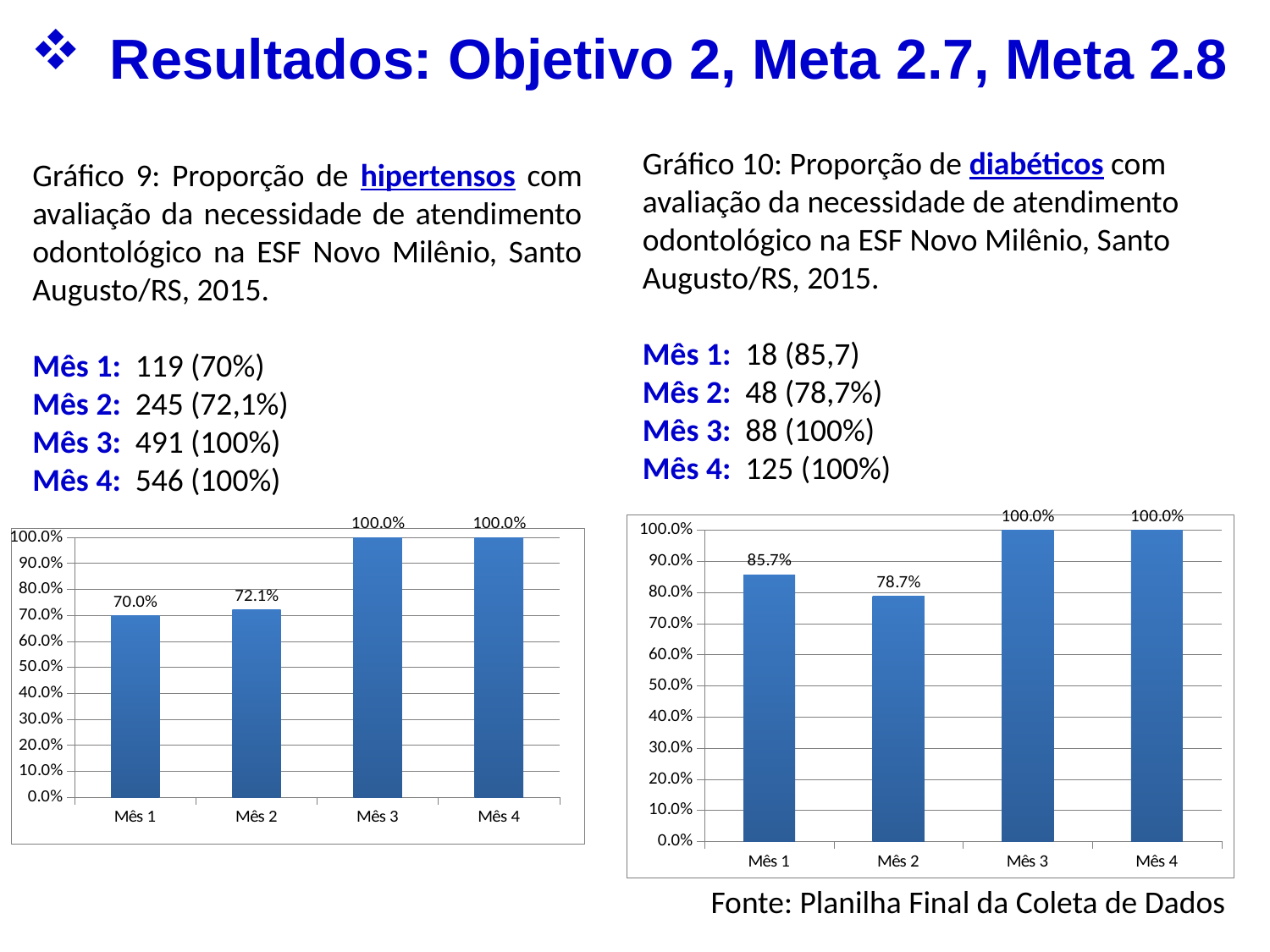
In the left chart (Gráfico 9, hipertensos), what is the difference between the values for Mês 3 and Mês 1? 30.0% What kind of chart is the right chart (Gráfico 10, diabéticos)? Bar chart How many months (categories) are shown in the left chart (Gráfico 9, hipertensos)? 4 In the right chart (Gráfico 10, diabéticos), what is the value for Mês 2? 78.7% In the right chart (Gráfico 10, diabéticos), what is the difference between the values for Mês 1 and Mês 2? 7.0% In the right chart (Gráfico 10, diabéticos), what is the value for Mês 1? 85.7% In the right chart (Gráfico 10, diabéticos), which month has the lowest value? Mês 2 In the left chart (Gráfico 9, hipertensos), which month has the lowest value? Mês 1 In the right chart (Gráfico 10, diabéticos), which is larger, the value for Mês 1 or the value for Mês 2? Mês 1 In the left chart (Gráfico 9, hipertensos), what is the value for Mês 1? 70.0% In the left chart (Gráfico 9, hipertensos), what is the value for Mês 2? 72.1% In the left chart (Gráfico 9, hipertensos), do the values rise or fall from Mês 1 to Mês 4? Rise